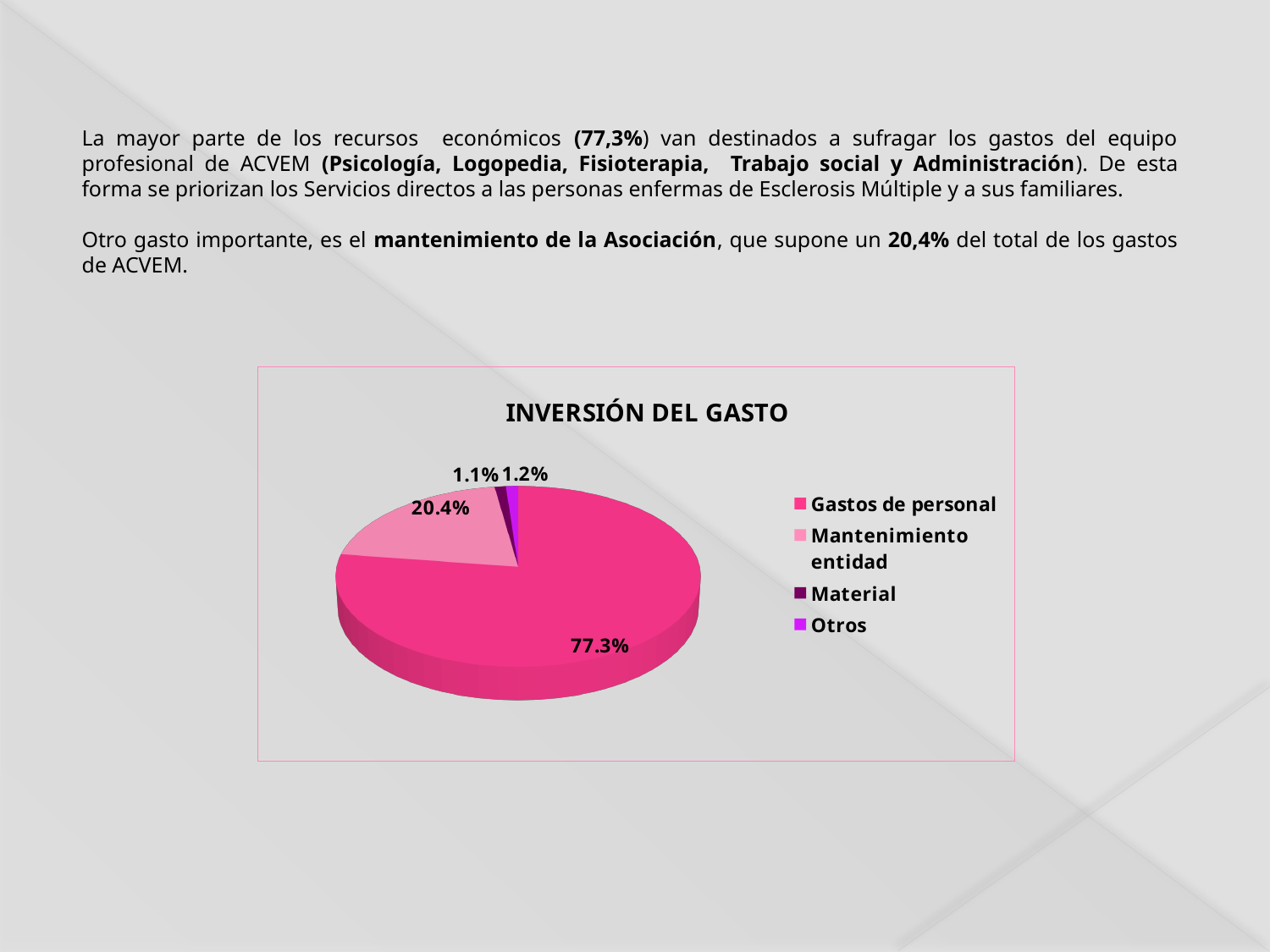
What percentage of the pie corresponds to Material? 1.1% What is the title of the chart? INVERSIÓN DEL GASTO How many categories does the legend list? 4 What percentage of the pie corresponds to Mantenimiento entidad? 20.4% What percentage of the pie corresponds to Otros? 1.2% What percentage of the pie corresponds to Gastos de personal? 77.3% Which category has the largest share of the pie? Gastos de personal What type of chart is shown on the slide? pie chart Which legend entry is shown in the lightest pink colour? Mantenimiento entidad Which is larger, the share for Mantenimiento entidad or the share for Otros? Mantenimiento entidad What is the difference in percentage points between Gastos de personal and Mantenimiento entidad? 56.9 What is the combined share of Material and Otros? 2.3%